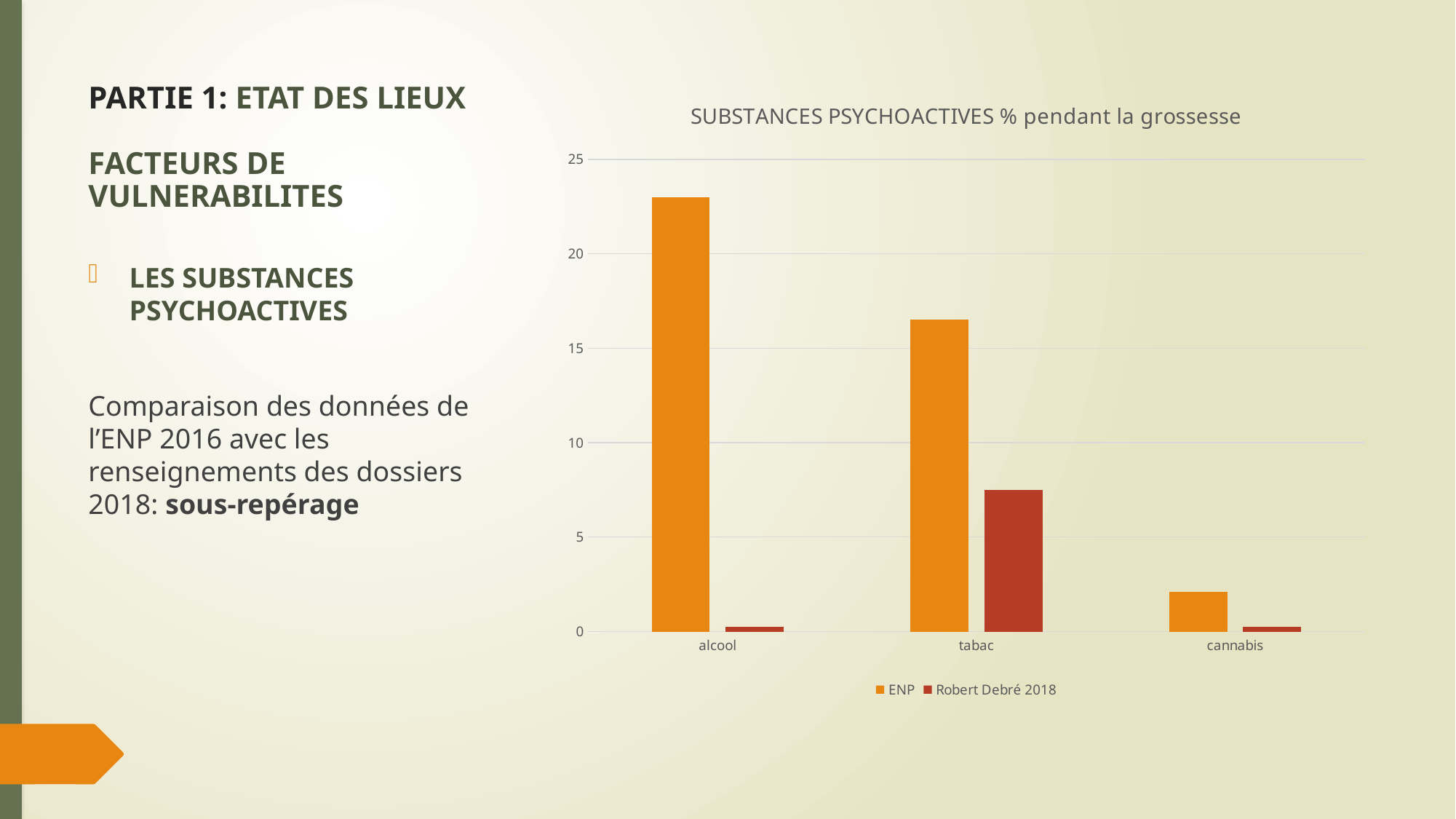
Which category has the highest Robert Debré 2018 value? tabac Is the ENP value for tabac greater or less than 15? greater How many categories are shown on the x axis of the chart? 3 What is the title of the chart? SUBSTANCES PSYCHOACTIVES % pendant la grossesse For tabac, which series has the larger value, ENP or Robert Debré 2018? ENP How many series does the chart legend list? 2 Which category has the lowest ENP value? cannabis Is the Robert Debré 2018 value for tabac greater or less than 10? less Which category has the highest ENP value? alcool What kind of chart is shown on the slide? bar chart Which series is shown in orange in the chart? ENP Is the ENP value for alcool greater or less than 20? greater